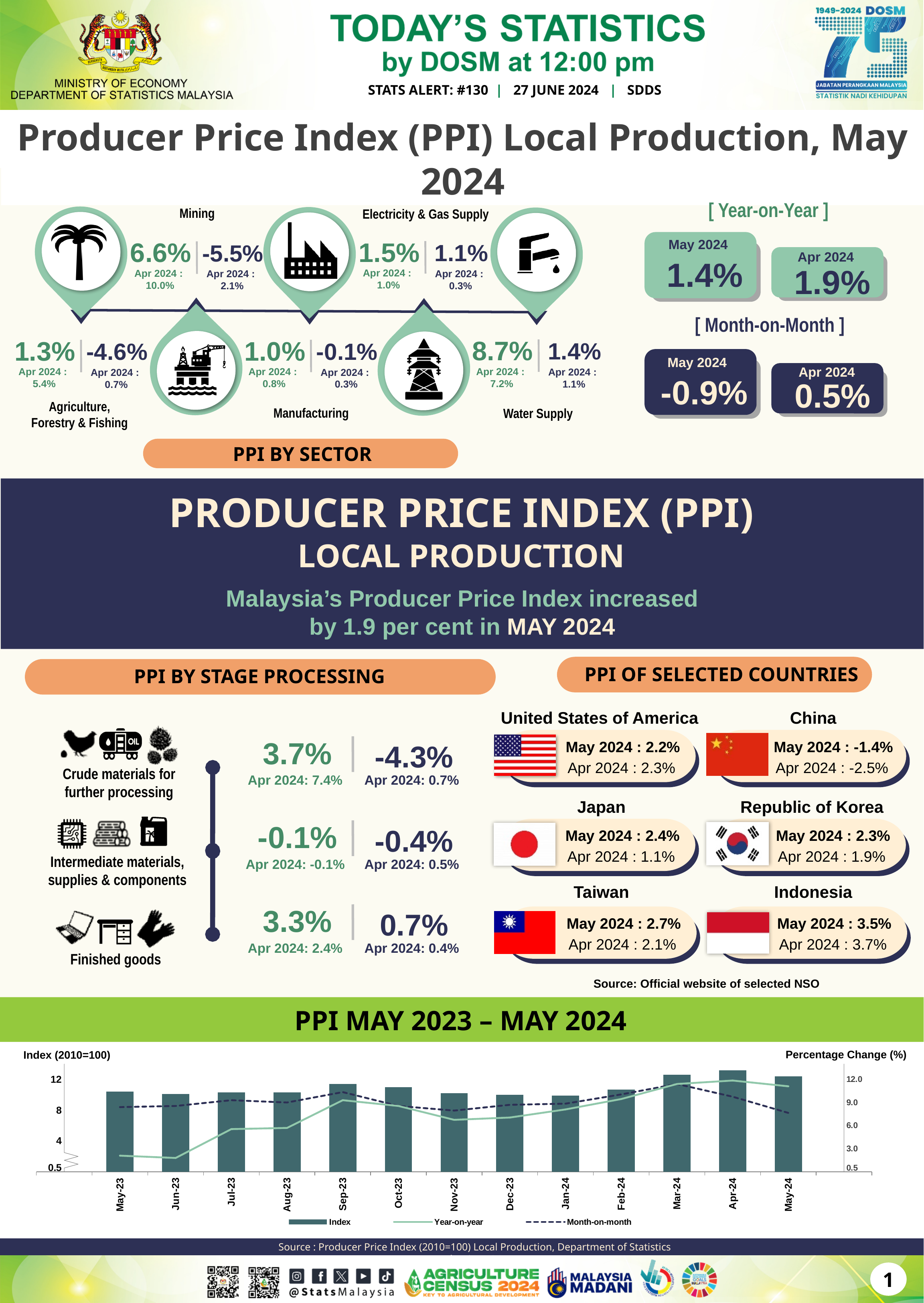
What are the three series named in the legend of the 'PPI MAY 2023 – MAY 2024' chart? Index, Year-on-year, Month-on-month In the 'PPI MAY 2023 – MAY 2024' chart, is the Index bar for Apr-24 greater or less than 12? greater What kind of chart is the 'PPI MAY 2023 – MAY 2024' chart? A combined bar and line chart In the 'PPI MAY 2023 – MAY 2024' chart, is the Year-on-year value for Apr-24 greater or less than 9.0? greater What is the label of the left vertical axis of the 'PPI MAY 2023 – MAY 2024' chart? Index (2010=100) In the 'PPI MAY 2023 – MAY 2024' chart, which month has the tallest Index bar? Apr-24 How many months are plotted on the x axis of the 'PPI MAY 2023 – MAY 2024' chart? 13 In the 'PPI MAY 2023 – MAY 2024' chart, which has the larger Index bar, Sep-23 or Jun-23? Sep-23 In the 'PPI MAY 2023 – MAY 2024' chart, does the Year-on-year line generally rise or fall from May-23 to Apr-24? rise In the 'PPI MAY 2023 – MAY 2024' chart, is the Index bar for Jun-23 greater or less than 12? less How many series does the legend of the 'PPI MAY 2023 – MAY 2024' chart list? 3